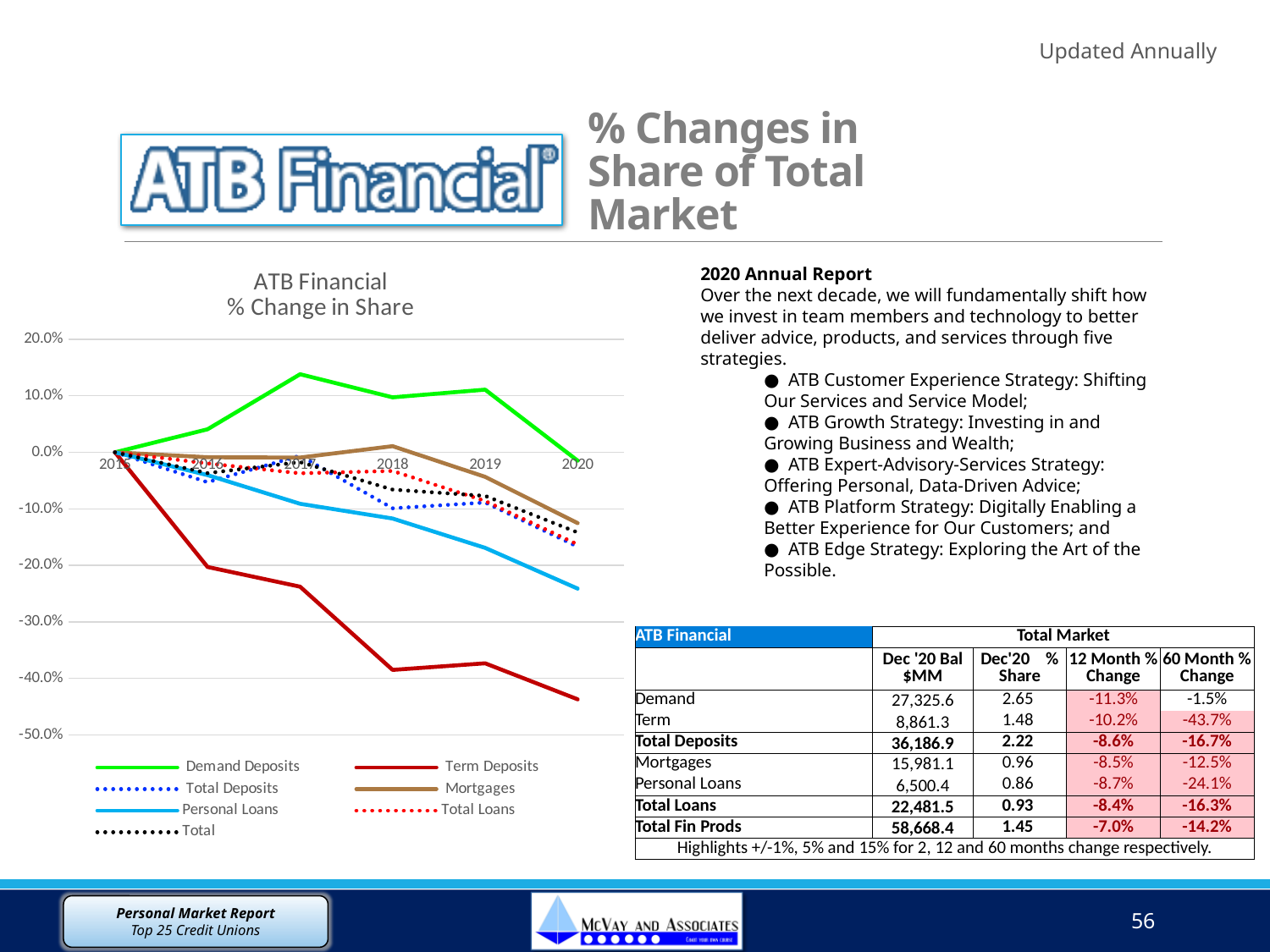
Which series has the lowest value in 2020? Term Deposits Is the value for Mortgages in 2020 greater or less than -20.0%? greater Does the Term Deposits line generally rise or fall from 2015 to 2020? fall In 2018, which is larger: the value for Personal Loans or the value for Term Deposits? Personal Loans How many years are plotted along the x axis of the chart? 6 Is the value for Personal Loans in 2020 greater or less than -20.0%? less Is the value for Term Deposits in 2020 greater or less than -40.0%? less How many series does the chart legend list? 7 What kind of chart is shown on the slide? line chart What is the title of the chart? ATB Financial % Change in Share Which series has the highest value in 2017? Demand Deposits